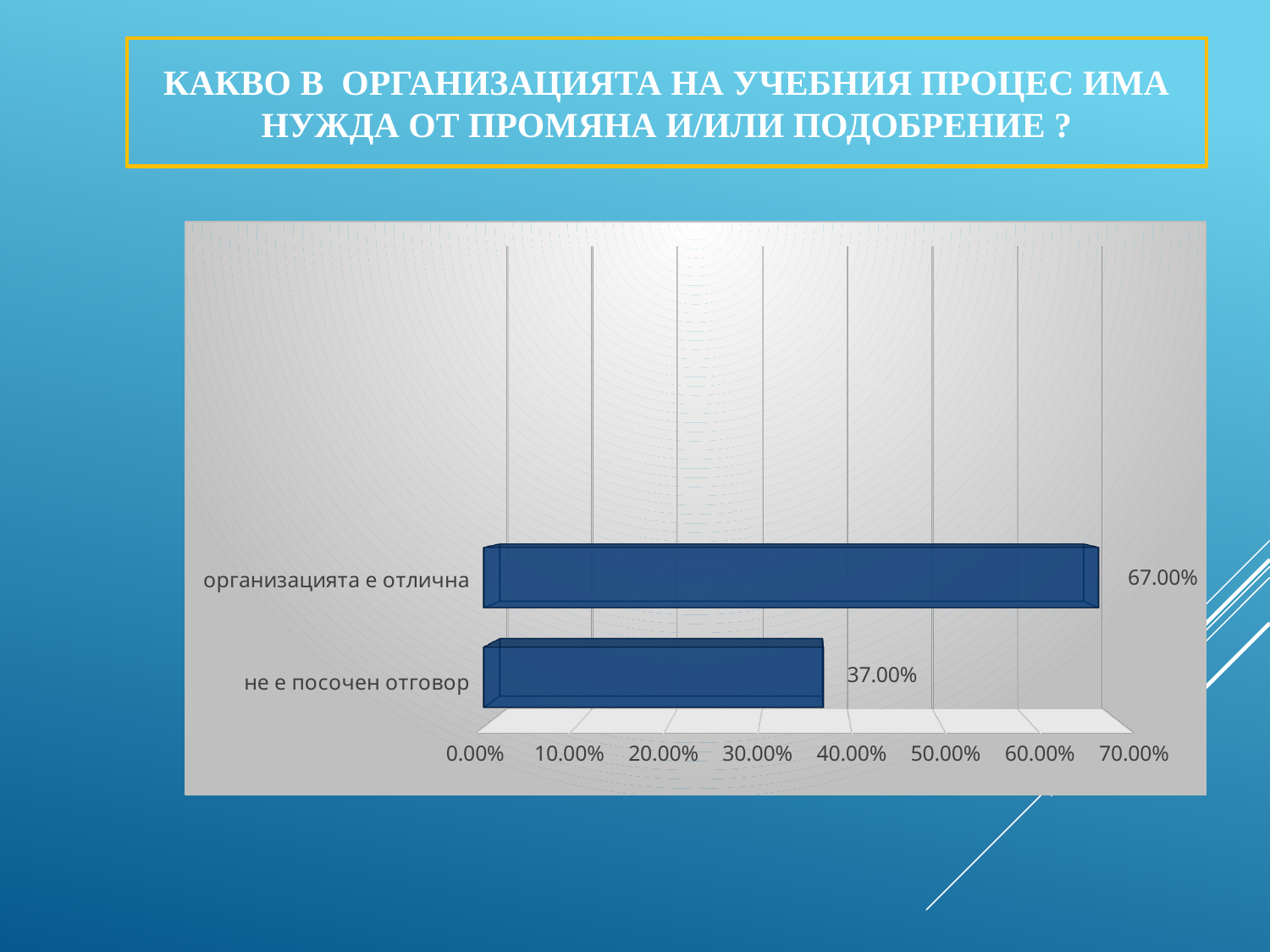
Is the value for "не е посочен отговор" greater or less than 40.00%? less What is the difference between the values for "организацията е отлична" and "не е посочен отговор"? 30.00% Which is larger: the value for "организацията е отлична" or the value for "не е посочен отговор"? организацията е отлична What is the value for "организацията е отлична"? 67.00% What is the highest value shown on the horizontal axis? 70.00% Is the value for "организацията е отлична" greater or less than 60.00%? greater Which category has the lowest value? не е посочен отговор What is the title of the slide above the chart? КАКВО В ОРГАНИЗАЦИЯТА НА УЧЕБНИЯ ПРОЦЕС ИМА НУЖДА ОТ ПРОМЯНА И/ИЛИ ПОДОБРЕНИЕ ? Which category has the highest value? организацията е отлична What is the value for "не е посочен отговор"? 37.00% How many categories are shown in the chart? 2 What kind of chart is shown on the slide? bar chart